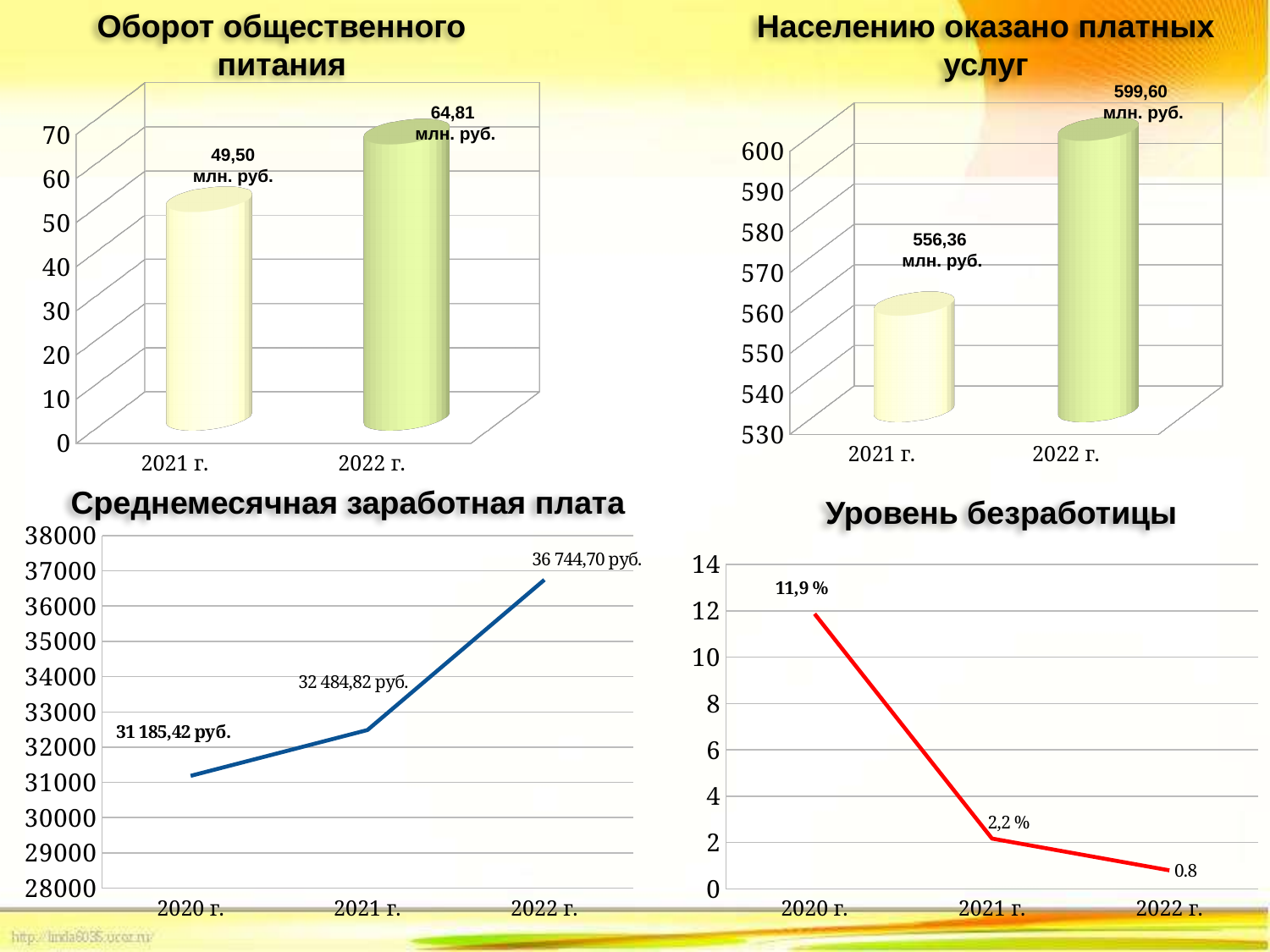
In the chart titled "Уровень безработицы", which year has the lowest value? 2022 г. In the chart titled "Среднемесячная заработная плата", how many data points are plotted? 3 In the chart titled "Оборот общественного питания", what is the value for 2022 г.? 64,81 млн. руб. In the chart titled "Населению оказано платных услуг", what is the value for 2021 г.? 556,36 млн. руб. In the chart titled "Среднемесячная заработная плата", do the values rise or fall from 2020 г. to 2022 г.? Rise In the chart titled "Населению оказано платных услуг", which year has the higher value? 2022 г. In the chart titled "Оборот общественного питания", by how much does the 2022 г. value exceed the 2021 г. value? 15,31 млн. руб. What kind of chart is the one titled "Населению оказано платных услуг"? Bar chart In the chart titled "Населению оказано платных услуг", what is the difference between the 2022 г. and 2021 г. values? 43,24 млн. руб. In the chart titled "Среднемесячная заработная плата", what is the value for 2022 г.? 36 744,70 руб. In the chart titled "Оборот общественного питания", what is the value for 2021 г.? 49,50 млн. руб. In the chart titled "Уровень безработицы", what is the value for 2020 г.? 11,9 %